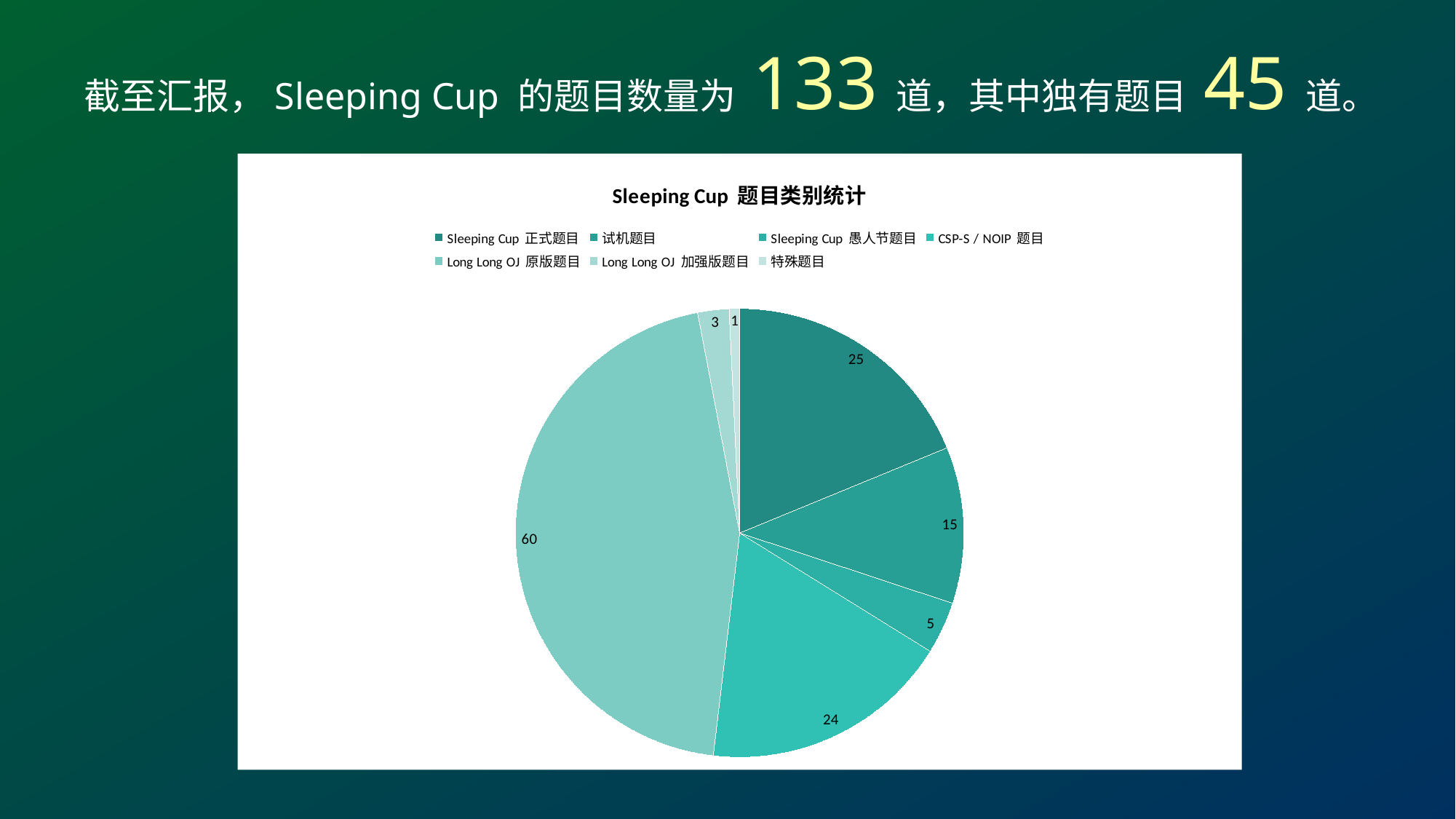
Which category has the smallest slice of the pie? 特殊题目 Which is larger, the value for Sleeping Cup 愚人节题目 or the value for Long Long OJ 加强版题目? Sleeping Cup 愚人节题目 What type of chart is shown on the slide? pie chart How many categories does the legend of the pie chart list? 7 What is the value for Long Long OJ 原版题目? 60 Which category has the largest slice of the pie? Long Long OJ 原版题目 What is the value for Sleeping Cup 正式题目? 25 What is the title of the chart? Sleeping Cup 题目类别统计 What is the value for 试机题目? 15 What is the value for 特殊题目? 1 What is the value for CSP-S / NOIP 题目? 24 What is the difference between the values for Long Long OJ 原版题目 and Sleeping Cup 正式题目? 35